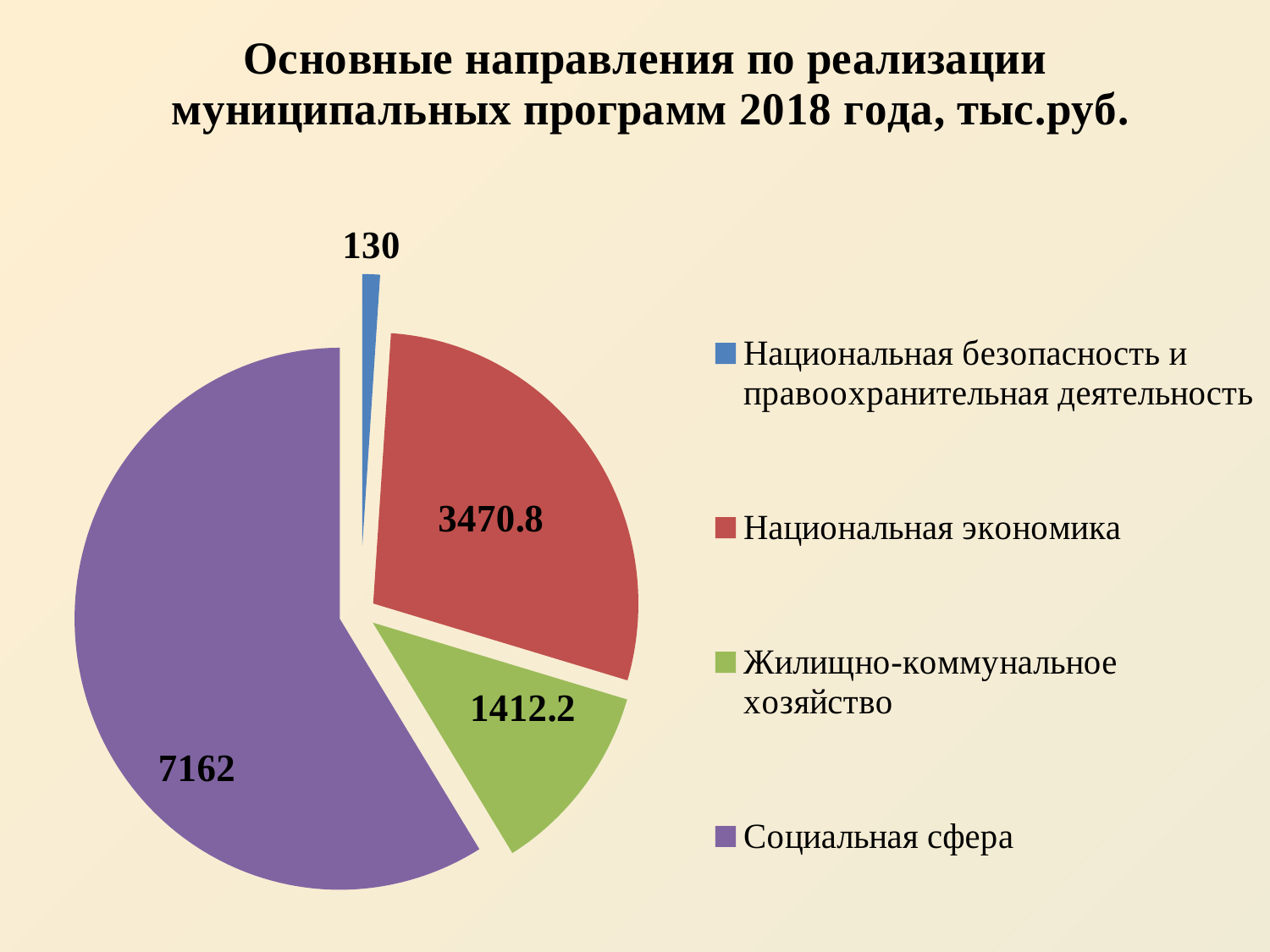
Which category has the largest slice of the pie? Социальная сфера What type of chart is shown on the slide? Pie chart What value is shown for Национальная экономика? 3470.8 What value is shown for Жилищно-коммунальное хозяйство? 1412.2 What is the difference between the values for Национальная экономика and Жилищно-коммунальное хозяйство? 2058.6 What value is shown for Социальная сфера? 7162 Which category has the smallest slice of the pie? Национальная безопасность и правоохранительная деятельность How many categories does the pie chart show? 4 Which is larger, the value for Жилищно-коммунальное хозяйство or the value for Национальная экономика? Национальная экономика What value is shown for Национальная безопасность и правоохранительная деятельность? 130 What colour is the slice for Социальная сфера? Purple What is the difference between the values for Социальная сфера and Национальная экономика? 3691.2